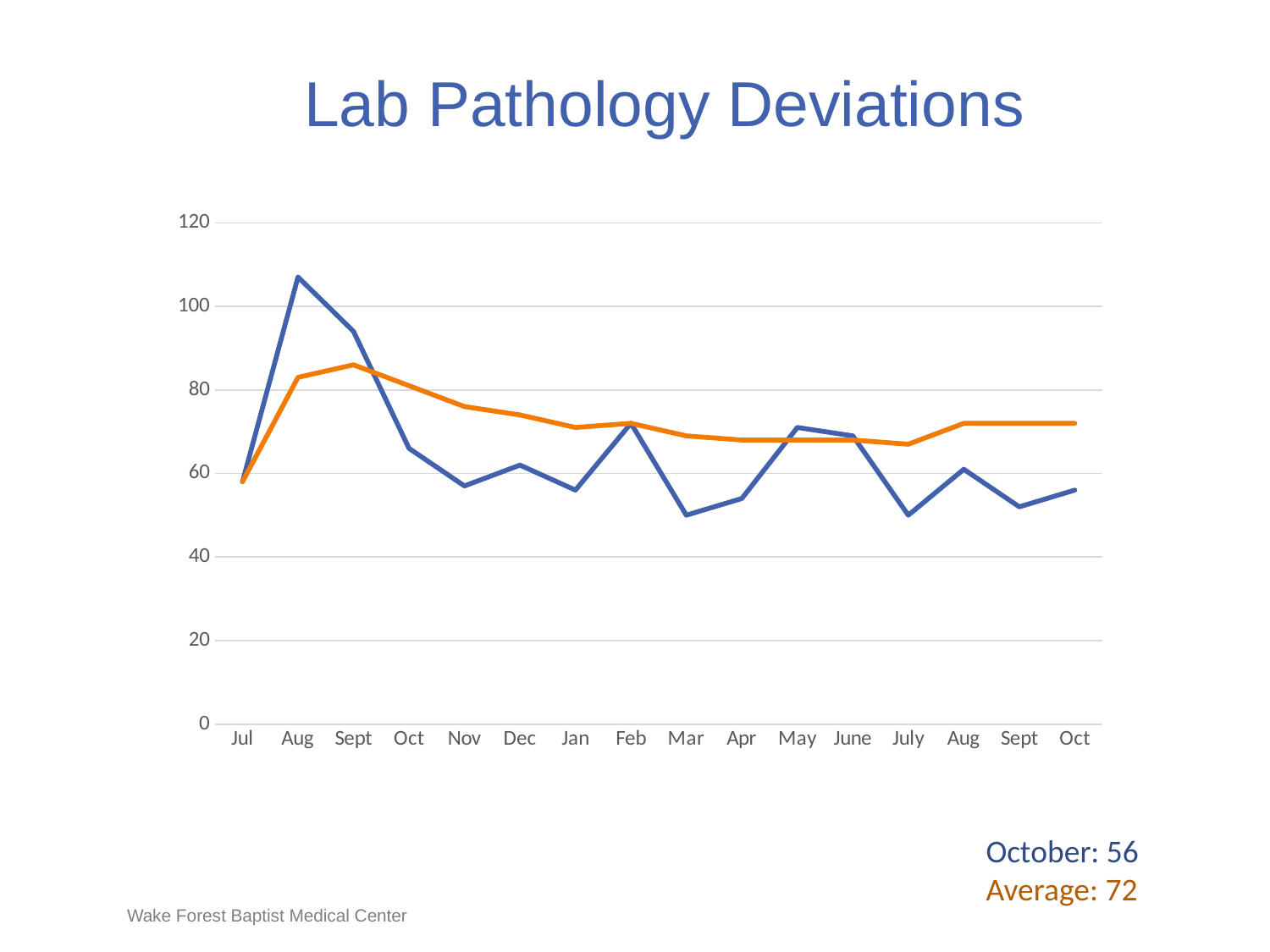
What is the title of the chart? Lab Pathology Deviations How many months are plotted along the x axis? 16 Is the blue line's value for the first Aug greater or less than 100? greater At which month does the blue line reach its highest point? Aug (the first Aug) Is the orange line's value for the first Sept greater or less than 80? greater What is the difference between the Average (72) and the final October value (56)? 16 Is the blue line's value for Mar greater or less than 60? less At Nov, which line is higher, the blue line or the orange line? the orange line What is the Average value printed on the slide? 72 Does the blue line rise or fall from the first Aug to the first Oct? fall What kind of chart is shown on the slide? line chart What is the value for the final October on the blue line, as printed on the slide? 56